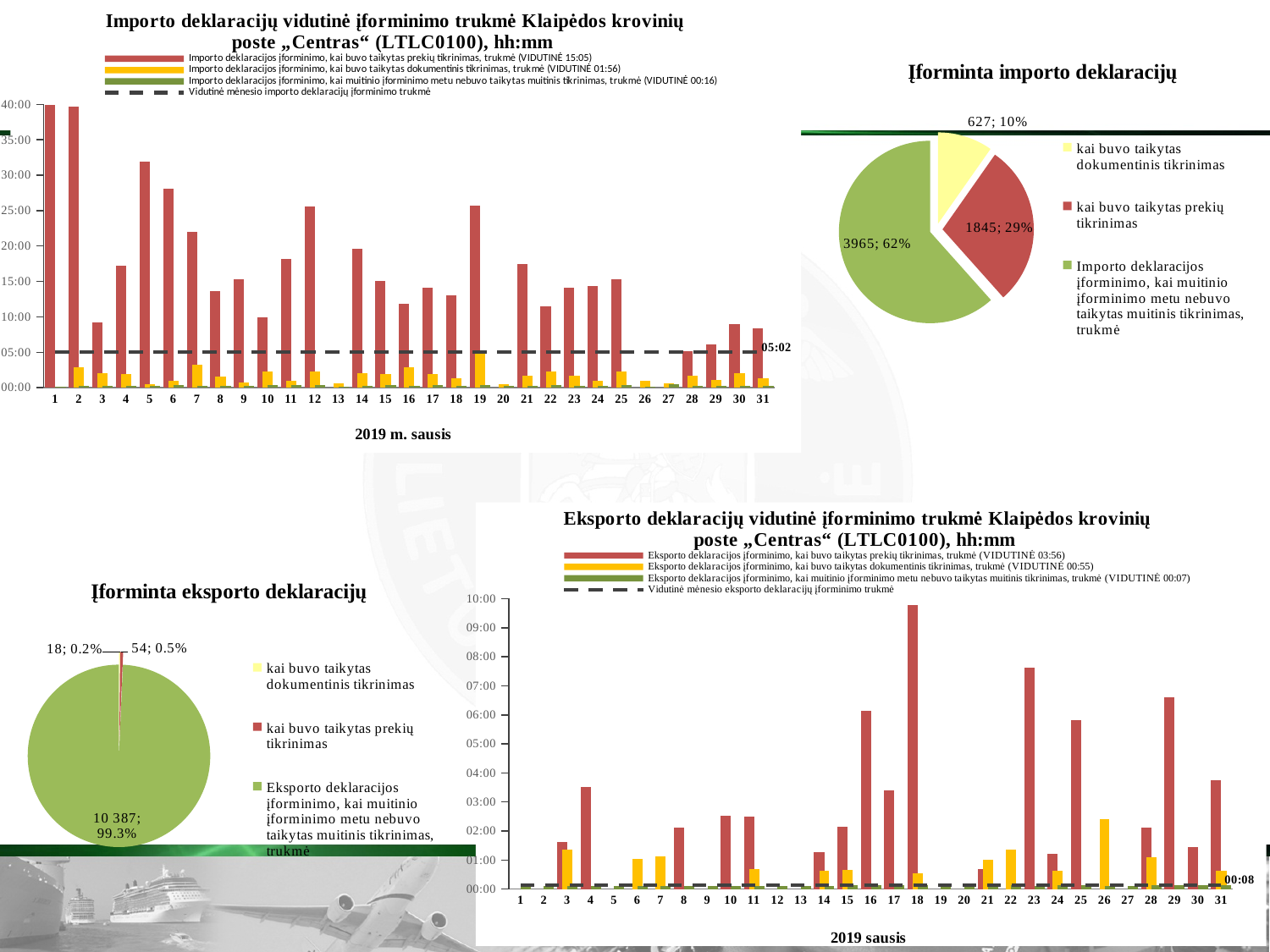
How many series does the legend of the chart "Importo deklaracijų vidutinė įforminimo trukmė Klaipėdos krovinių poste „Centras“ (LTLC0100), hh:mm" list? 4 In the chart "Importo deklaracijų vidutinė įforminimo trukmė Klaipėdos krovinių poste „Centras“ (LTLC0100), hh:mm", what value is labelled on the dashed monthly average line? 05:02 In the pie chart "Įforminta importo deklaracijų", what value is shown for the slice "kai buvo taikytas prekių tikrinimas"? 1845; 29% How many slices does the pie chart "Įforminta eksporto deklaracijų" have? 3 In the pie chart "Įforminta importo deklaracijų", what share of the pie does the slice "kai buvo taikytas dokumentinis tikrinimas" represent? 10% In the chart "Eksporto deklaracijų vidutinė įforminimo trukmė Klaipėdos krovinių poste „Centras“ (LTLC0100), hh:mm", is the red bar for day 18 greater or less than 09:00? greater In the chart "Eksporto deklaracijų vidutinė įforminimo trukmė Klaipėdos krovinių poste „Centras“ (LTLC0100), hh:mm", on which day is the red bar (goods check) highest? 18 In the pie chart "Įforminta eksporto deklaracijų", what value is shown for the largest slice? 10 387; 99.3% In the pie chart "Įforminta eksporto deklaracijų", which category has the smallest slice? kai buvo taikytas dokumentinis tikrinimas In the pie chart "Įforminta importo deklaracijų", what is the difference between the count for the slice with no customs check (3965) and the slice with goods check (1845)? 2120 In the pie chart "Įforminta importo deklaracijų", which category has the largest slice? Importo deklaracijos įforminimo, kai muitinio įforminimo metu nebuvo taikytas muitinis tikrinimas, trukmė What kind of chart is "Eksporto deklaracijų vidutinė įforminimo trukmė Klaipėdos krovinių poste „Centras“ (LTLC0100), hh:mm"? bar chart